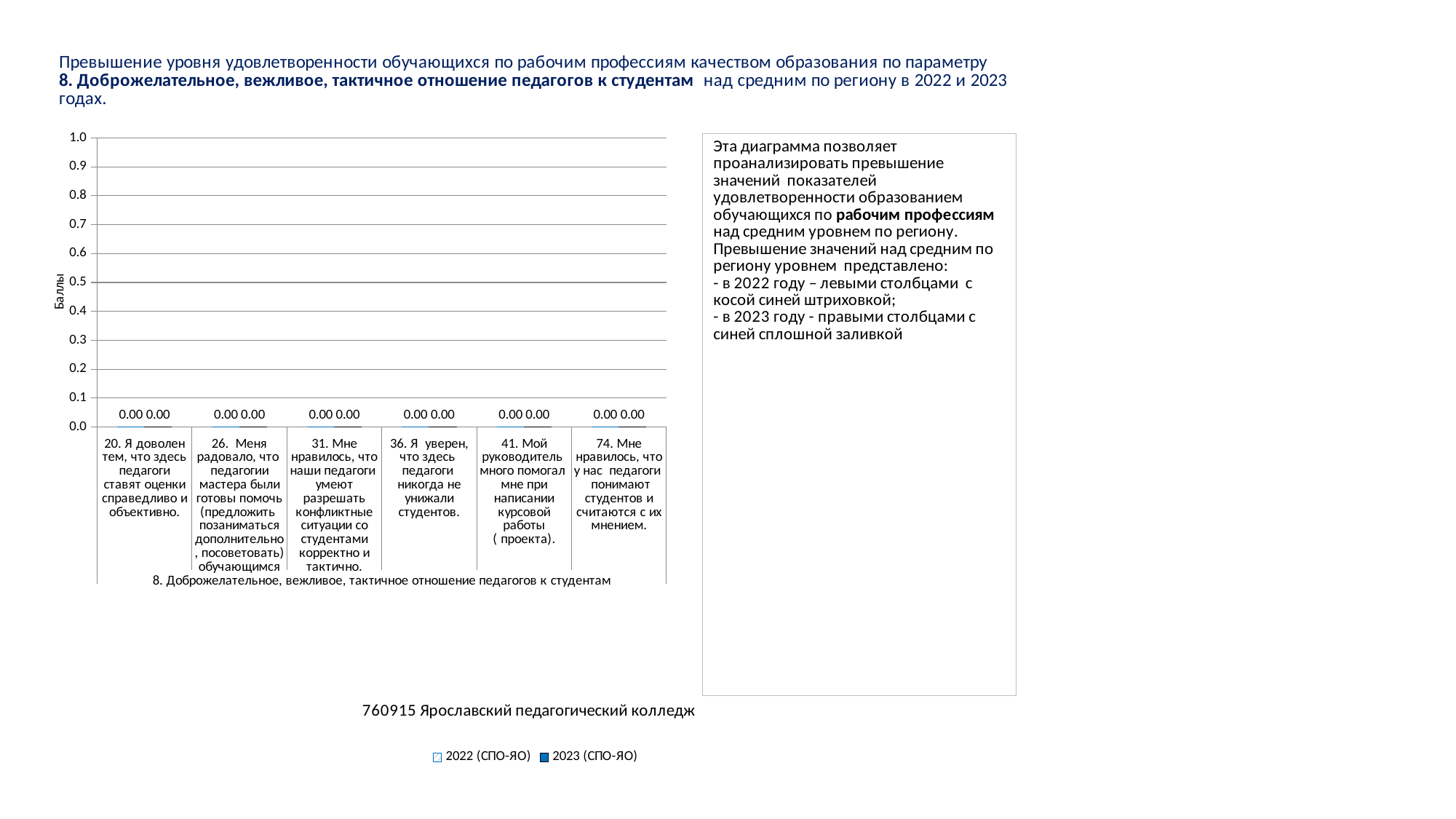
What is the difference between the 2022 (СПО-ЯО) and 2023 (СПО-ЯО) values for category 31? 0.00 Is the value for 2023 (СПО-ЯО) for category 26 greater or less than 0.5? less How many series does the legend list? 2 What is the value for 2023 (СПО-ЯО) for category 74 (Мне нравилось, что у нас педагоги понимают студентов и считаются с их мнением)? 0.00 What is the value for 2022 (СПО-ЯО) for category 20 (Я доволен тем, что здесь педагоги ставят оценки справедливо и объективно)? 0.00 How many categories are shown on the x axis of the chart? 6 What are the two legend entries of the chart? 2022 (СПО-ЯО) and 2023 (СПО-ЯО) What is the value for 2022 (СПО-ЯО) for category 41 (Мой руководитель много помогал мне при написании курсовой работы)? 0.00 Do the 2022 (СПО-ЯО) values rise, fall, or stay the same across the categories on the x axis? stay the same What is the label of the vertical axis of the chart? Баллы What type of chart is shown on the slide? bar chart What is the value for 2023 (СПО-ЯО) for category 36 (Я уверен, что здесь педагоги никогда не унижали студентов)? 0.00